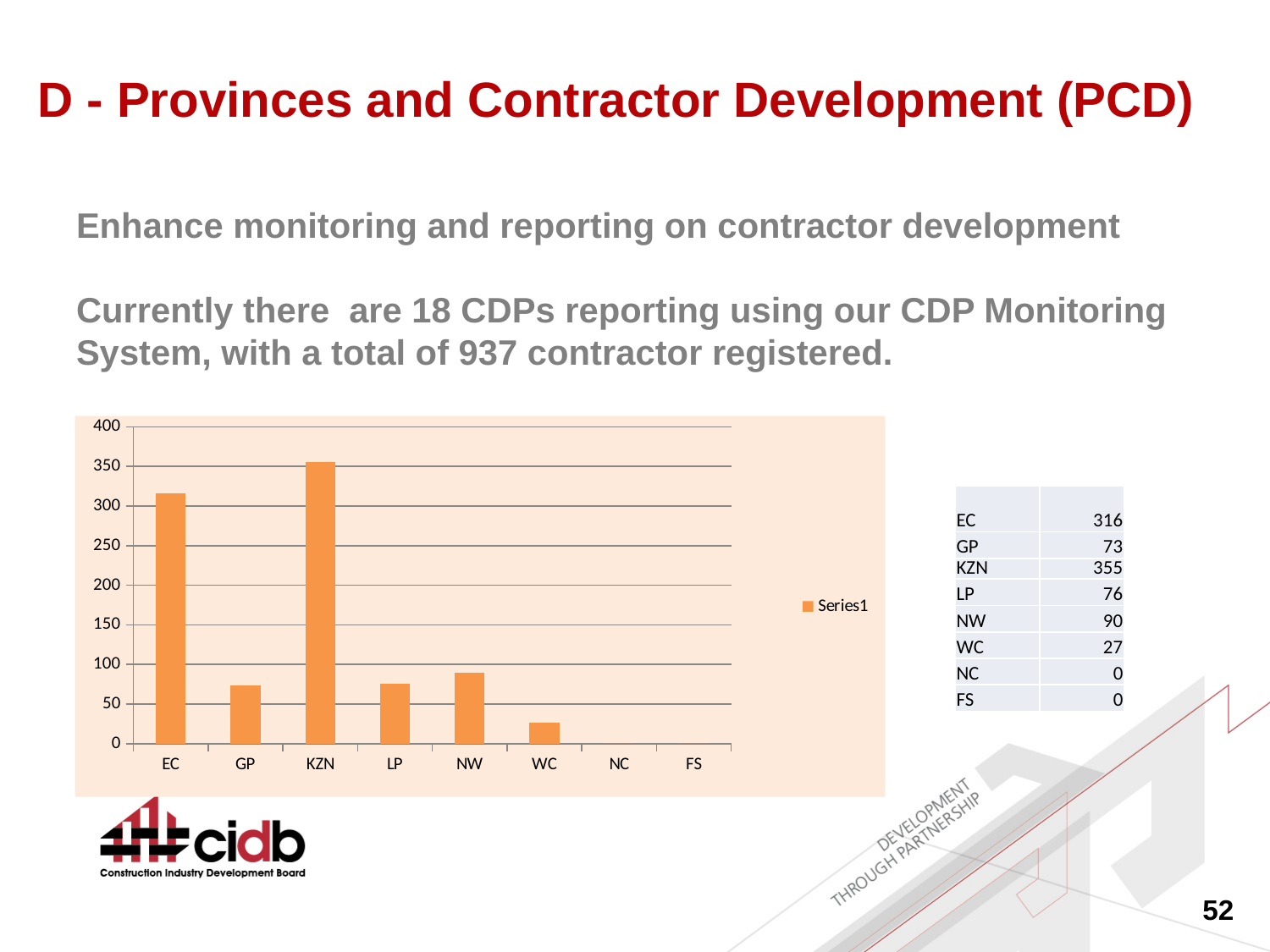
What is the value for EC according to the table beside the chart? 316 What is the value for WC according to the table beside the chart? 27 Is the value for GP greater or less than 100? less How many series does the chart legend list? 1 Which category has the highest value in the chart? KZN What is the name of the series shown in the chart legend? Series1 Is the value for EC greater or less than 300? greater What is the value for KZN according to the table beside the chart? 355 What kind of chart is shown on the slide? bar chart Which is larger, the value for NW or the value for LP? NW How many categories are shown on the x axis of the chart? 8 What is the difference between the values for KZN and EC? 39